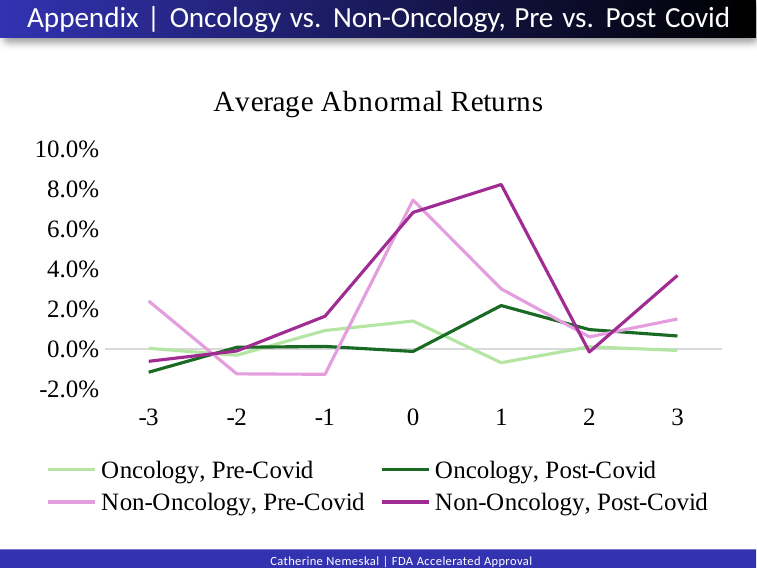
Is the value for Oncology, Pre-Covid at x = 0 greater or less than 2.0%? less Does the Non-Oncology, Post-Covid line rise or fall from x = -3 to x = 1? rise Is the value for Non-Oncology, Pre-Covid at x = -2 greater or less than 0.0%? less Is the value for Non-Oncology, Post-Covid at x = 1 greater or less than 6.0%? greater What is the title of the chart? Average Abnormal Returns What kind of chart is shown on the slide? line chart Which series is drawn in dark green? Oncology, Post-Covid At x = 1, which series has the larger value: Non-Oncology, Post-Covid or Oncology, Post-Covid? Non-Oncology, Post-Covid How many points are plotted along the x axis for each series? 7 How many series does the legend list? 4